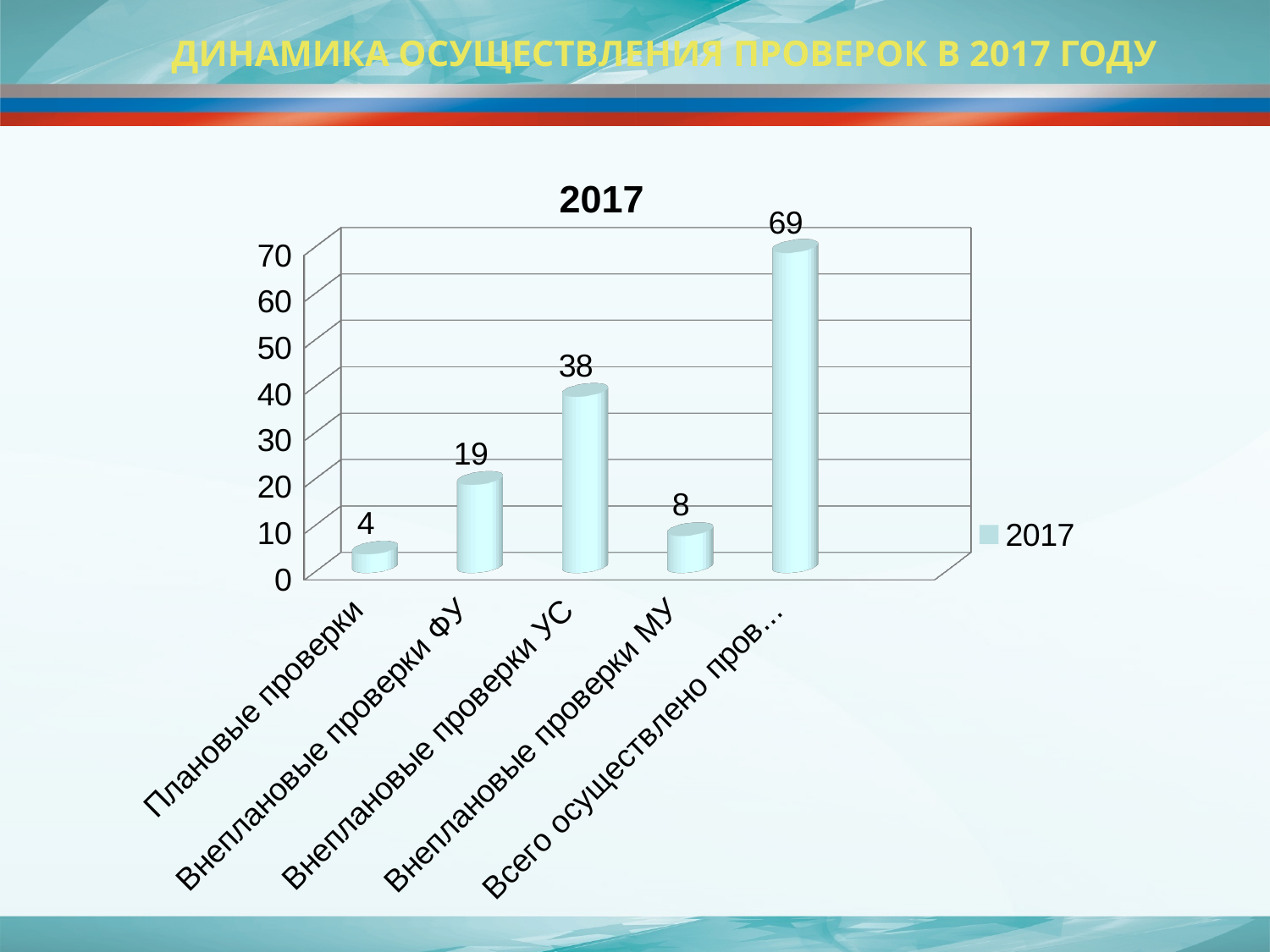
How many categories are shown on the x axis? 5 What kind of chart is shown on the slide? bar chart What is the difference between the values for Внеплановые проверки УС and Внеплановые проверки ФУ? 19 What is the value for Внеплановые проверки ФУ? 19 What is the value for Плановые проверки? 4 What is the title of the chart? 2017 Which is larger, the value for Внеплановые проверки ФУ or the value for Внеплановые проверки МУ? Внеплановые проверки ФУ Is the value for Внеплановые проверки УС greater or less than 30? greater Which category has the highest value? Всего осуществлено пров... Which category has the lowest value? Плановые проверки What is the value for Внеплановые проверки УС? 38 What is the value for Внеплановые проверки МУ? 8